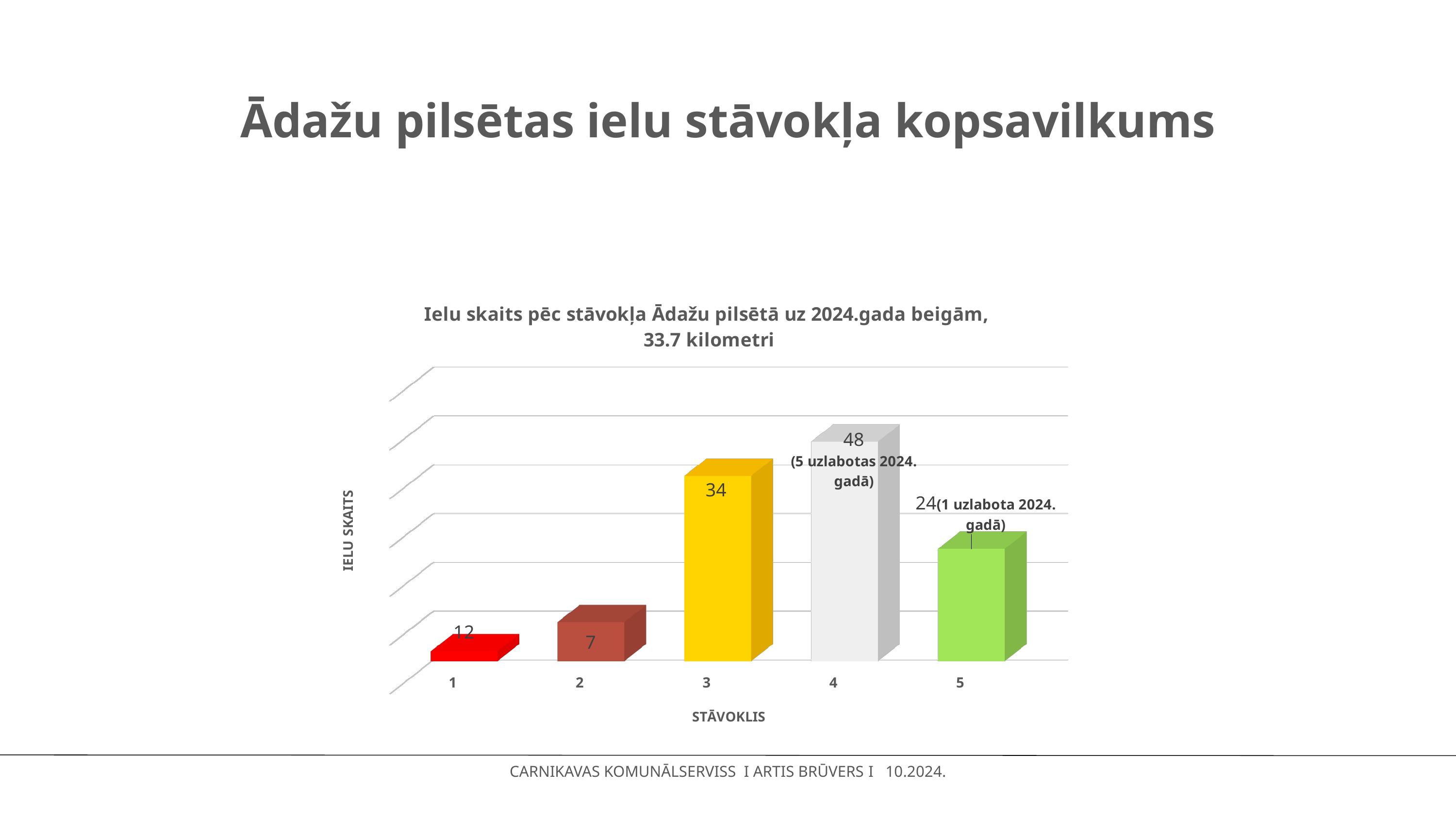
Which is larger, the value for condition 5 or the value for condition 1? condition 5 What is the value for condition (stāvoklis) 2? 7 How many condition categories are shown on the x axis? 5 What is the value for condition (stāvoklis) 1? 12 What is the difference between the values for condition 4 and condition 3? 14 What is the label of the x axis of the chart? STĀVOKLIS What is the value for condition (stāvoklis) 3? 34 What is the value for condition (stāvoklis) 5? 24 What is the value for condition (stāvoklis) 4? 48 What kind of chart is shown on the slide? bar chart Which condition category has the highest number of streets? 4